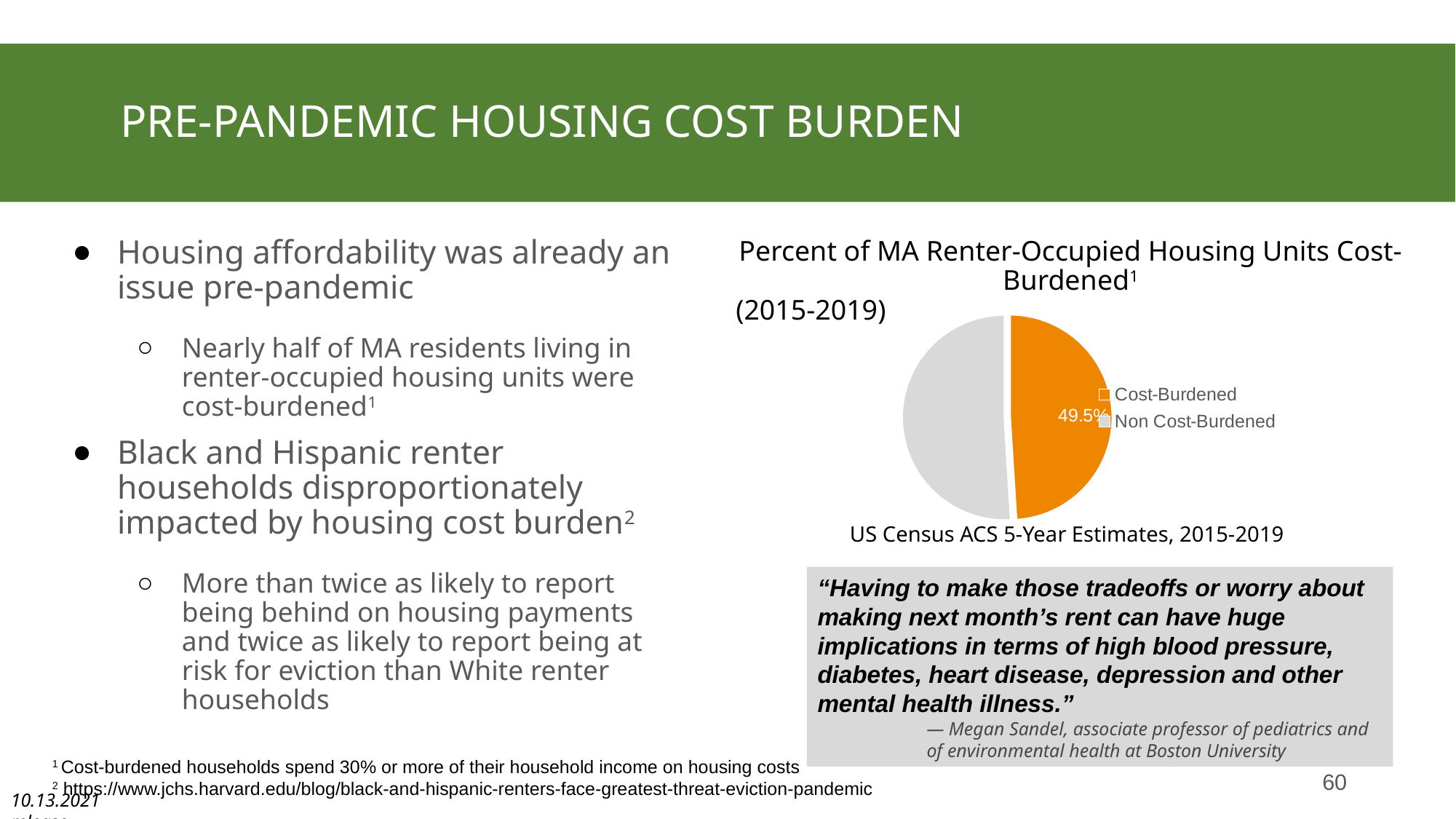
What is the title of the pie chart? Percent of MA Renter-Occupied Housing Units Cost-Burdened (2015-2019) How many entries does the pie chart's legend list? 2 Is the value for Cost-Burdened greater or less than 50%? less What share of the pie does the Cost-Burdened slice represent? 49.5% What kind of chart is shown on the slide? Pie chart What percentage of MA renter-occupied housing units were cost-burdened according to the pie chart? 49.5% Which legend entry is shown in orange in the pie chart? Cost-Burdened How many slices does the pie chart have? 2